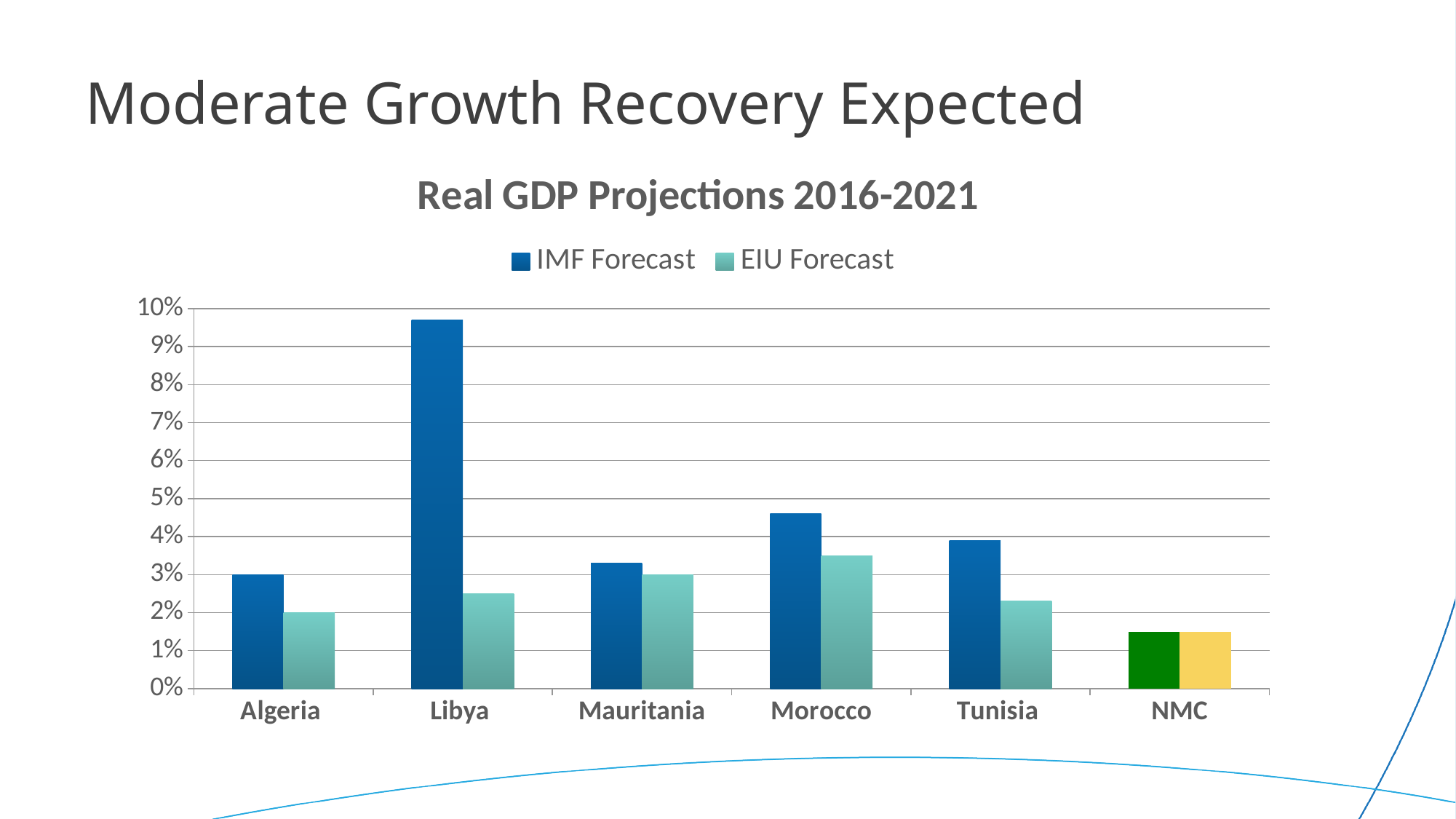
How many series does the legend list? 2 For Libya, which is larger: the IMF Forecast or the EIU Forecast? IMF Forecast Is the IMF Forecast value for Libya greater or less than 9%? greater Is the EIU Forecast value for Libya greater or less than 3%? less How many categories are shown on the x axis? 6 What is the title of the chart? Real GDP Projections 2016-2021 Which category has the lowest IMF Forecast value? NMC Which category has the highest IMF Forecast value? Libya What type of chart is shown on the slide? bar chart Is the IMF Forecast value for Morocco greater or less than 4%? greater Which category has the highest EIU Forecast value? Morocco